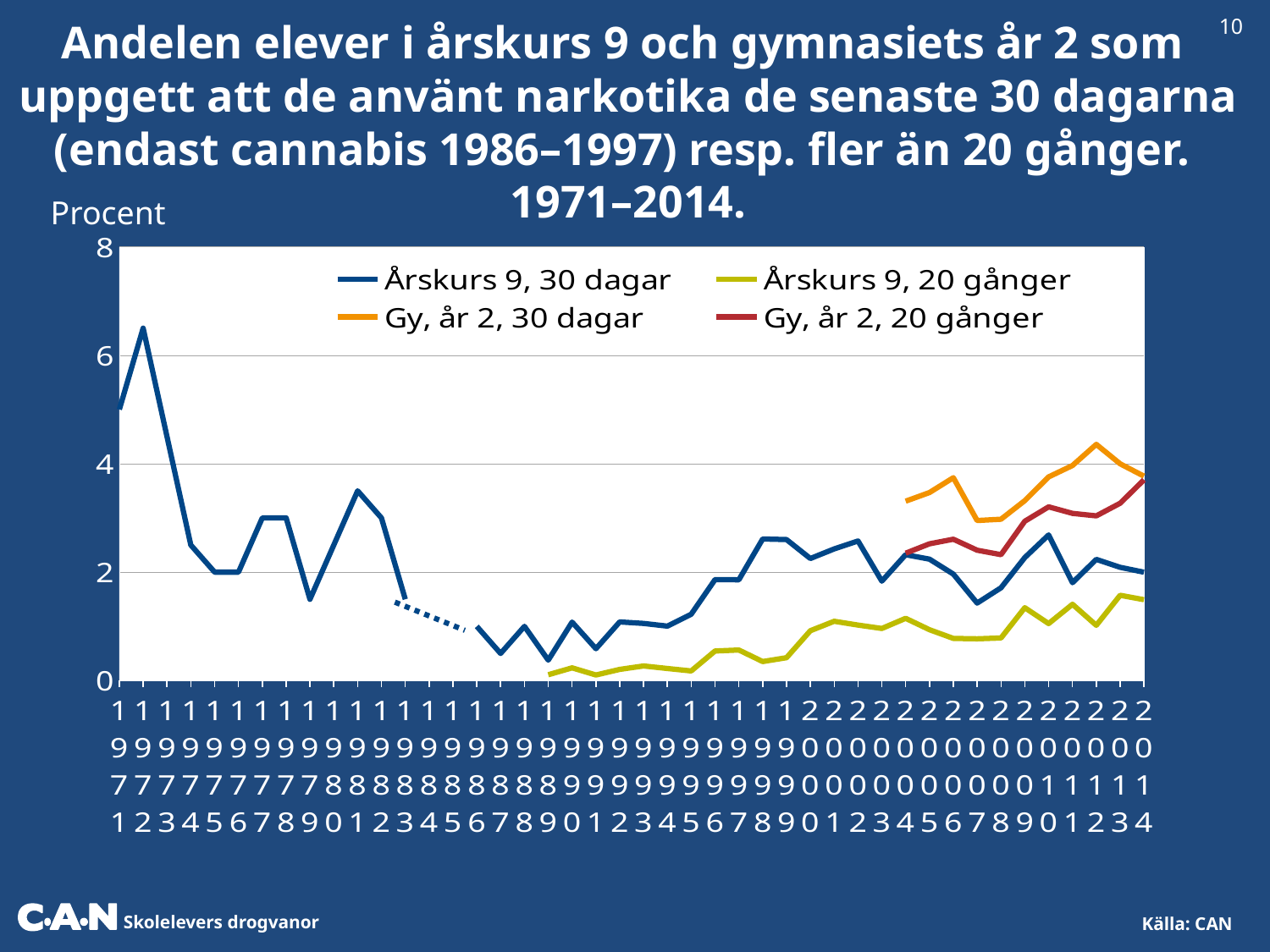
In which year does the series Årskurs 9, 30 dagar reach its highest value? 1972 Does the series Årskurs 9, 30 dagar rise or fall between 1972 and 1975? fall Is the value for Årskurs 9, 30 dagar in 1972 greater or less than 6? greater Is the value for Gy, år 2, 20 gånger in 2014 greater or less than 2? greater Which series reaches the highest value anywhere on the chart? Årskurs 9, 30 dagar In 2014, which is larger: the value for Gy, år 2, 30 dagar or the value for Årskurs 9, 30 dagar? Gy, år 2, 30 dagar What is the label on the vertical axis of the chart? Procent How many series does the legend list? 4 Is the value for Årskurs 9, 20 gånger in 2014 greater or less than 2? less What is the highest value shown on the vertical axis? 8 What kind of chart is shown on the slide? line chart